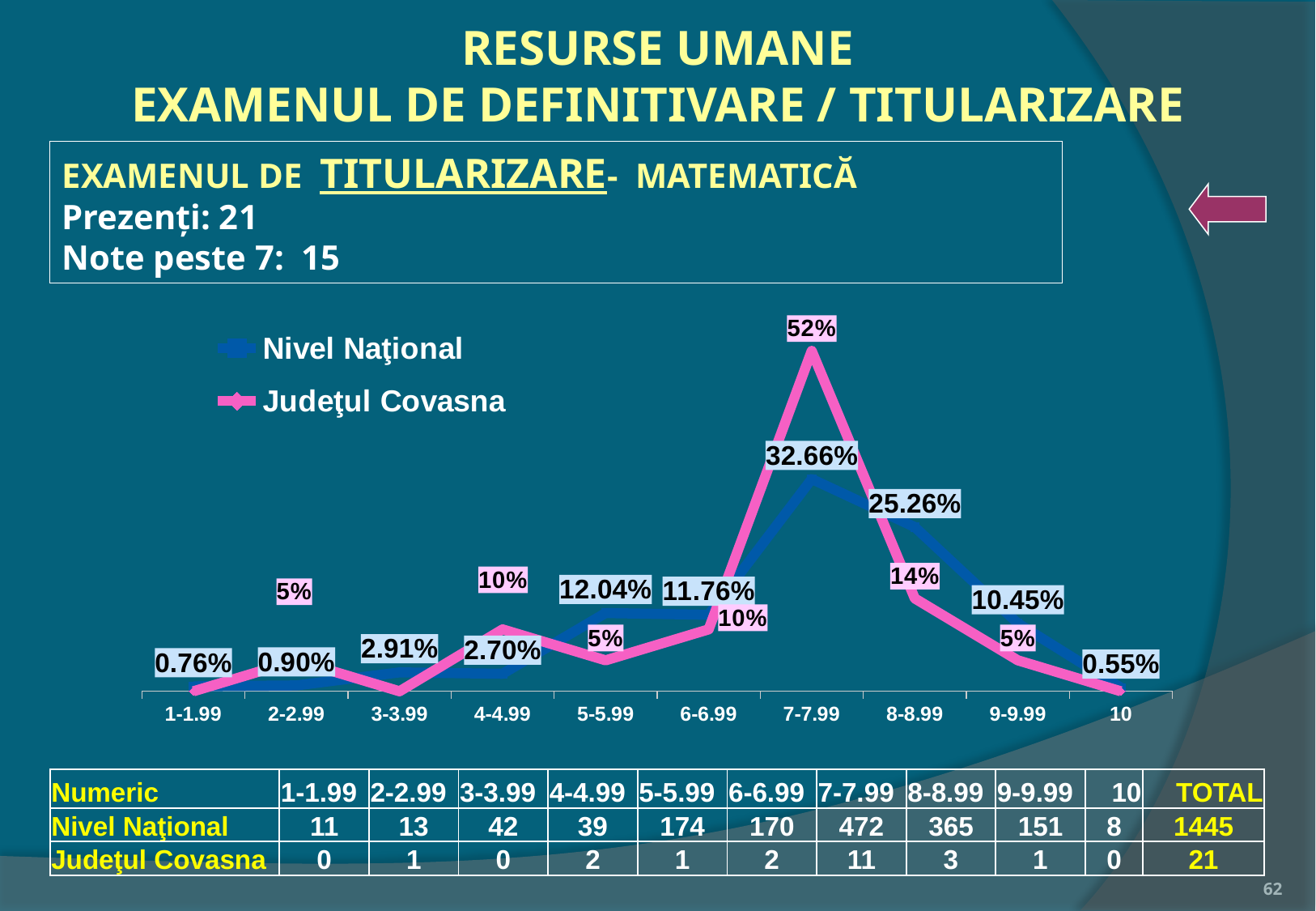
Which interval has the lowest Nivel Naţional value? 10 For the 5-5.99 interval, which series has the larger value, Nivel Naţional or Judeţul Covasna? Nivel Naţional What is the Nivel Naţional value for the 7-7.99 interval? 32.66% What is the Nivel Naţional value for the 8-8.99 interval? 25.26% What is the difference between the Judeţul Covasna and Nivel Naţional values for the 7-7.99 interval? 19.34% Which interval has the highest Nivel Naţional value? 7-7.99 How many series does the chart legend list? 2 What kind of chart is shown on the slide? line chart What is the Judeţul Covasna value for the 8-8.99 interval? 14% How many score intervals are shown on the x axis of the chart? 10 What is the Nivel Naţional value for the 10 interval? 0.55% What is the Judeţul Covasna value for the 7-7.99 interval? 52%